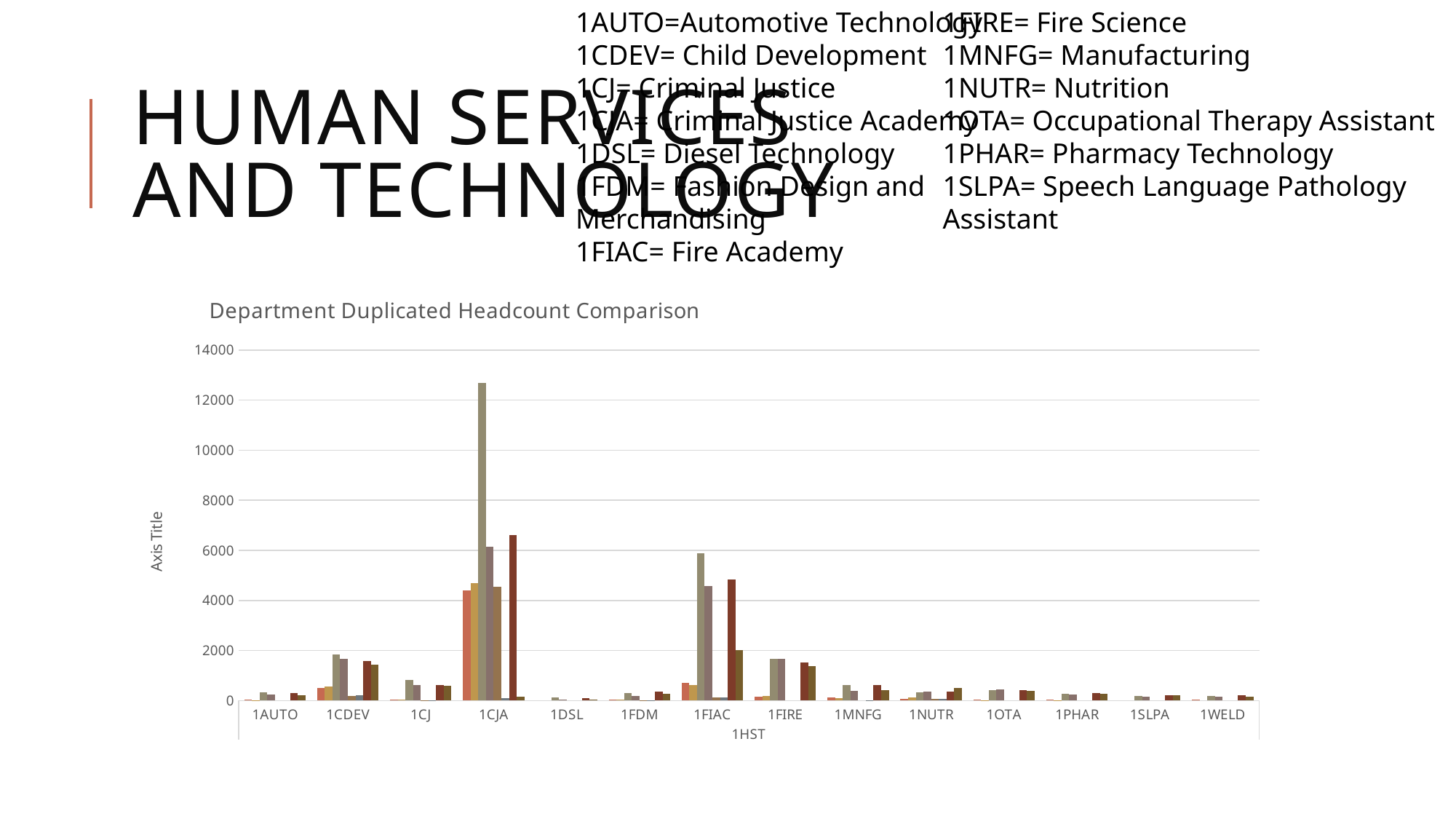
Is the tallest bar for 1CJA greater or less than 12000? greater Is the tallest bar for 1CDEV greater or less than 1000? greater Which category contains the tallest bar in the chart? 1CJA Is the tallest bar for 1FIRE greater or less than 4000? less Which category has the taller tallest bar, 1FIRE or 1DSL? 1FIRE Which category has the taller tallest bar, 1CJA or 1FIAC? 1CJA What label is shown on the x axis of the chart? 1HST What kind of chart is shown on the slide? bar chart How many department categories are shown along the x axis of the chart? 14 What is the title of the chart on the slide? Department Duplicated Headcount Comparison